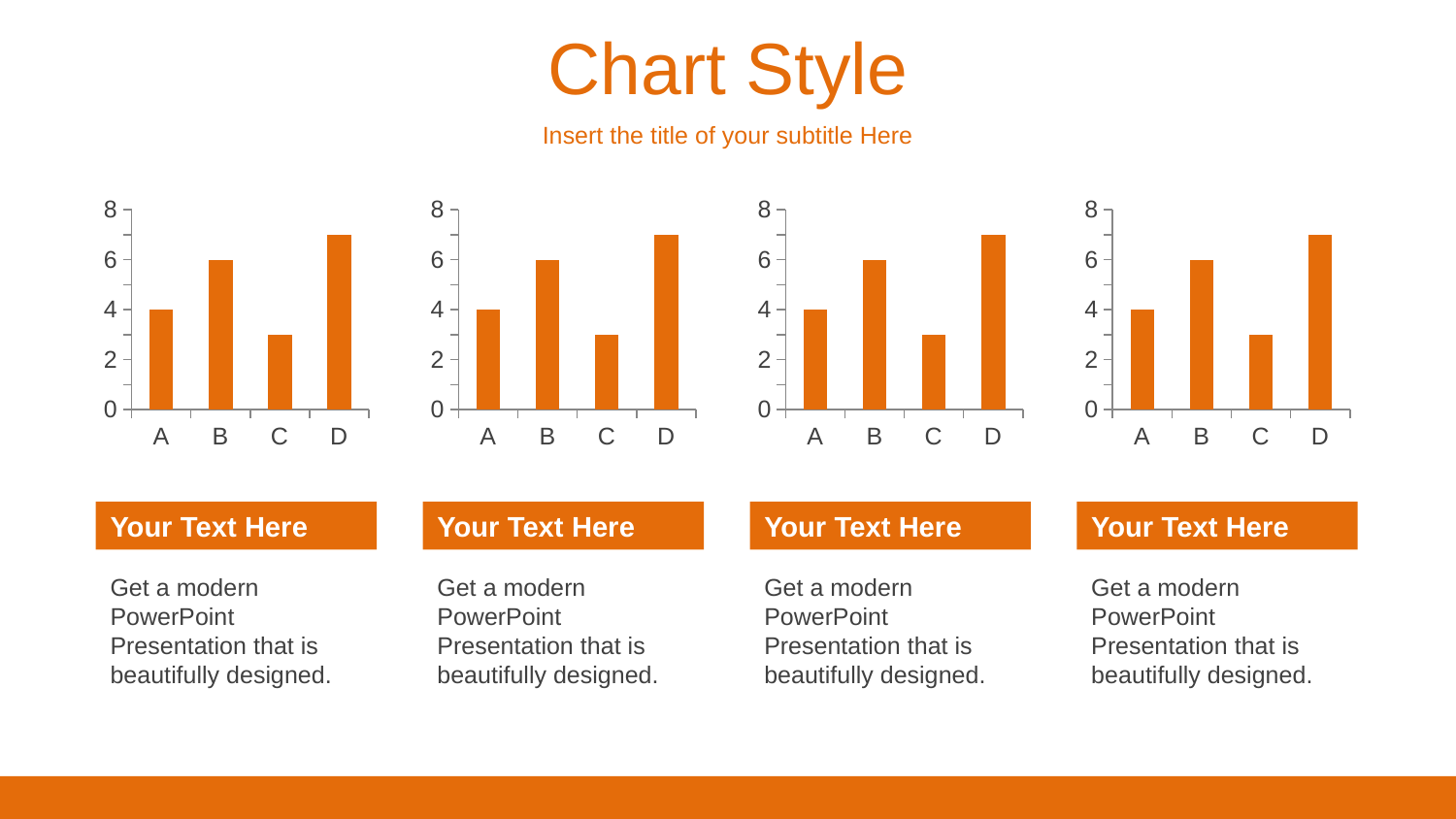
What type of chart is the second chart from the left? bar chart How many categories are shown on the x axis of the leftmost chart? 4 In the third chart from the left, is the value for category D greater or less than 6? greater In the leftmost chart, what is the value for category B? 6 In the second chart from the left, which category has the lowest bar? C What is the highest value shown on the y axis of the rightmost chart? 8 In the leftmost chart, what is the value for category A? 4 In the second chart from the left, which category has the highest bar? D In the rightmost chart, which is larger, the value for A or the value for B? B In the rightmost chart, what is the difference between the values for B and A? 2 In the third chart from the left, is the value for category C greater or less than 4? less How many charts are shown on the slide? 4